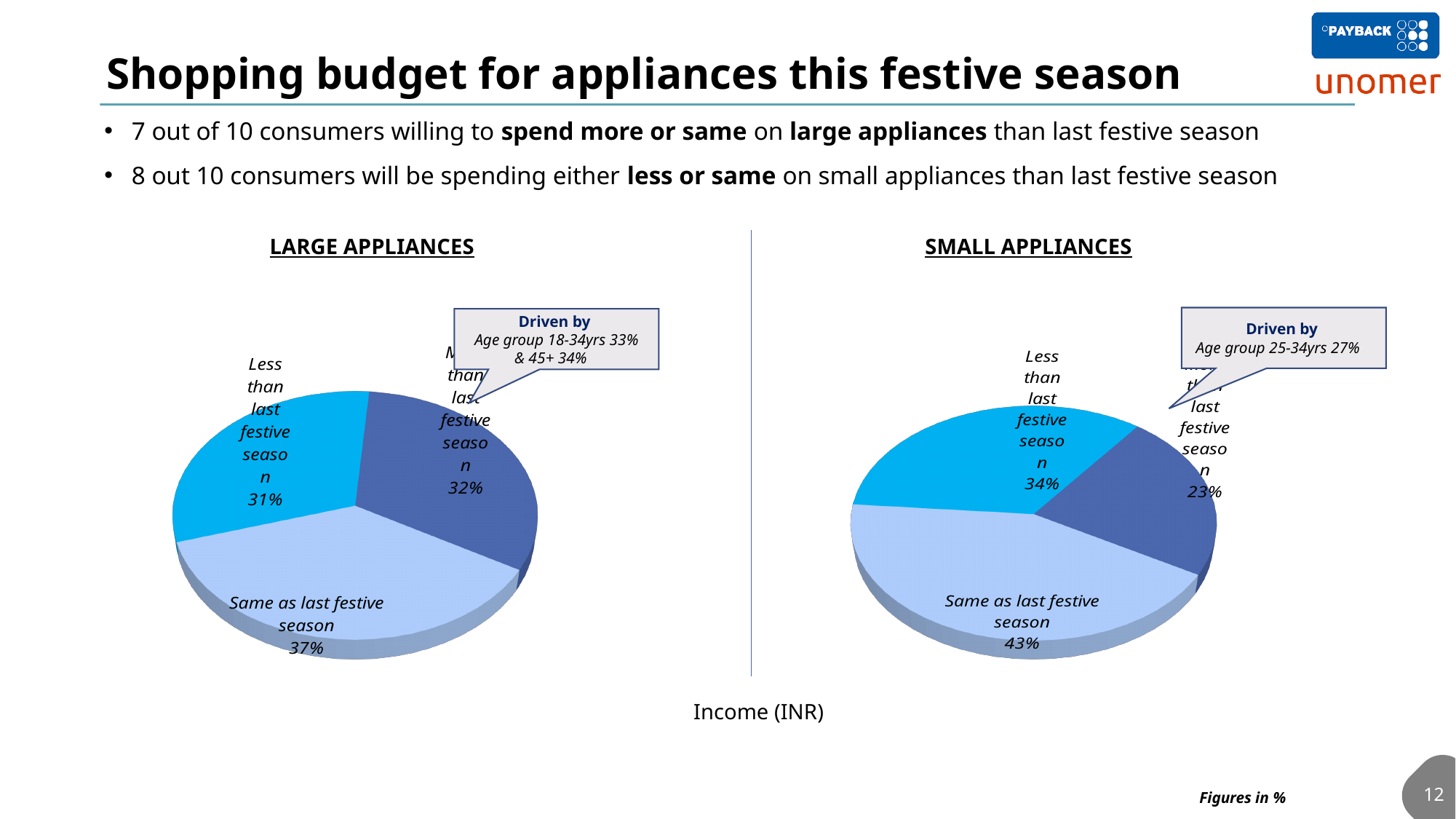
What type of chart is used for Small Appliances? Pie chart In the Small Appliances pie chart, what is the difference between the 'Same as last festive season' share and the 'Less than last festive season' share? 9% How many slices does the Large Appliances pie chart have? 3 In the Small Appliances pie chart, what share of consumers will spend more than last festive season? 23% In the Small Appliances pie chart, what share of consumers will spend less than last festive season? 34% In the Large Appliances pie chart, which category has the largest share? Same as last festive season Which is larger: the 'Same as last festive season' share for Large Appliances or for Small Appliances? Small Appliances In the Large Appliances pie chart, what share of consumers will spend the same as last festive season? 37% In the Small Appliances pie chart, what share of consumers will spend the same as last festive season? 43% According to the callout on the Small Appliances chart, which age group drives the 'More than last festive season' segment? Age group 25-34yrs 27% In the Small Appliances pie chart, which category has the smallest share? More than last festive season In the Large Appliances pie chart, what share of consumers will spend less than last festive season? 31%